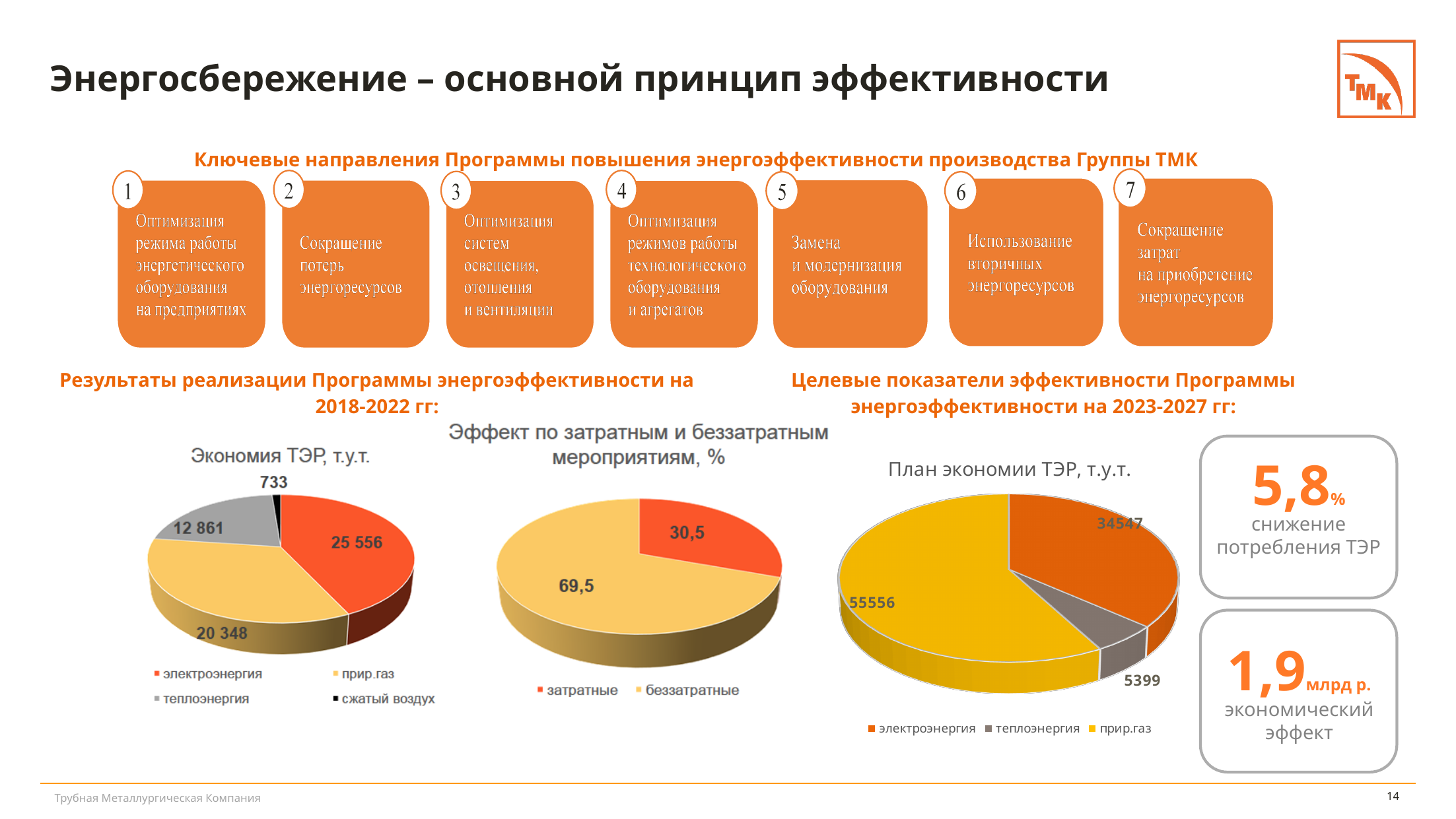
In the chart titled "Экономия ТЭР, т.у.т.", how many categories does the legend list? 4 In the chart titled "Экономия ТЭР, т.у.т.", which category has the lowest value? сжатый воздух In the chart titled "Экономия ТЭР, т.у.т.", what is the difference between электроэнергия and сжатый воздух? 24 823 In the chart titled "План экономии ТЭР, т.у.т.", what is the value for теплоэнергия? 5399 In the chart titled "План экономии ТЭР, т.у.т.", which is larger: электроэнергия or теплоэнергия? электроэнергия In the chart titled "Экономия ТЭР, т.у.т.", what is the value for сжатый воздух? 733 In the chart titled "Экономия ТЭР, т.у.т.", what is the value for электроэнергия? 25 556 What kind of chart is "Эффект по затратным и беззатратным мероприятиям, %"? pie chart In the chart titled "План экономии ТЭР, т.у.т.", which category has the highest value? прир.газ In the chart titled "Эффект по затратным и беззатратным мероприятиям, %", what share of the pie do затратные measures take? 30,5% In the chart titled "Эффект по затратным и беззатратным мероприятиям, %", what is the value for беззатратные? 69,5 In the chart titled "План экономии ТЭР, т.у.т.", what is the total of all three categories? 95502